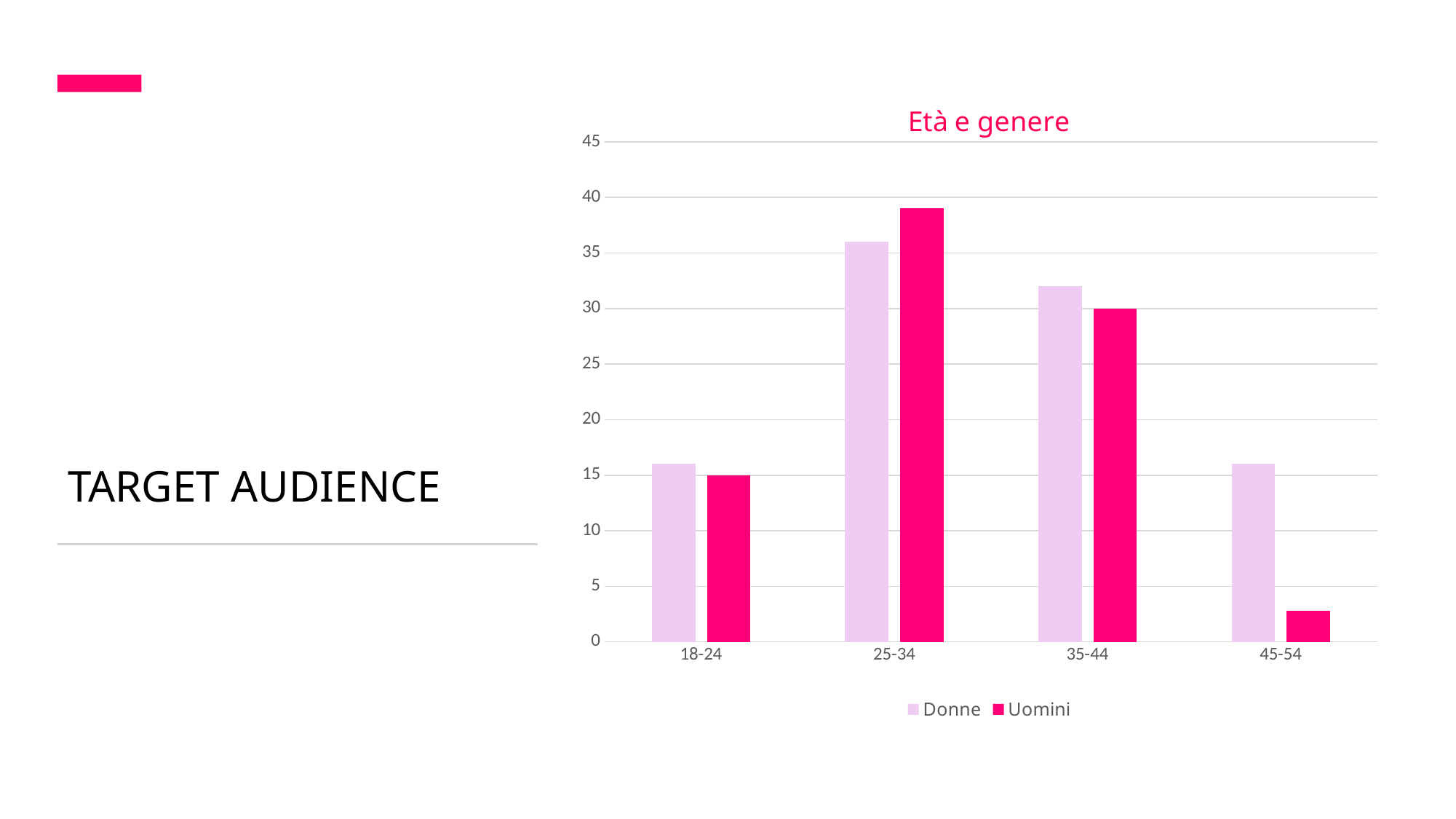
Is the value for Donne in the 25-34 age group greater or less than 35? greater How many series does the legend list? 2 How many age categories are shown on the x axis? 4 What is the value for Uomini in the 35-44 age group? 30 Which age group has the highest value for Uomini? 25-34 What is the value for Uomini in the 18-24 age group? 15 Which age group has the lowest value for Uomini? 45-54 In the 45-54 age group, which is larger, Donne or Uomini? Donne In the 25-34 age group, which is larger, Donne or Uomini? Uomini What type of chart is shown on the slide? bar chart What is the title of the chart? Età e genere Which age group has the highest value for Donne? 25-34